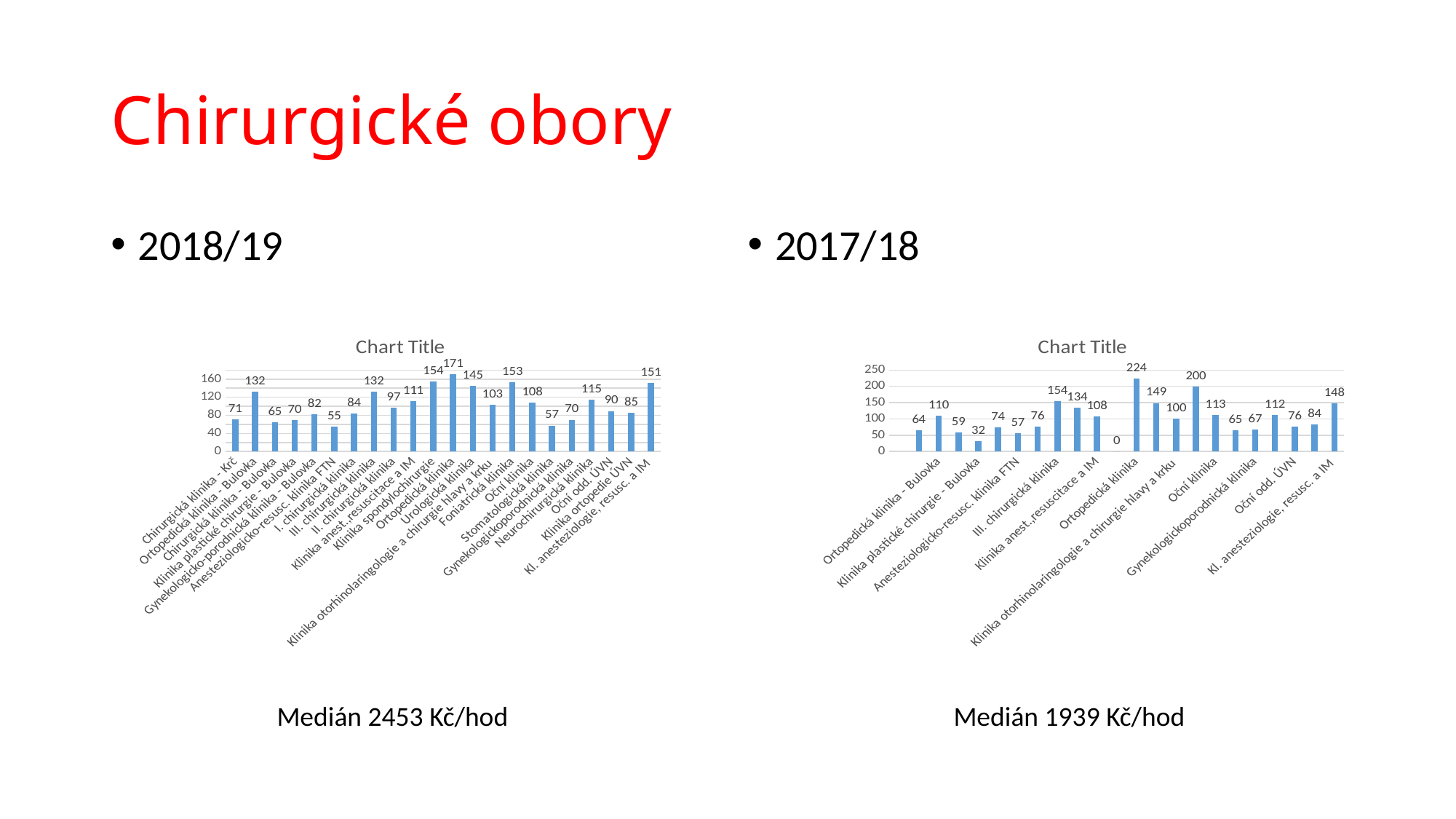
In the left chart (2018/19), which category has the lowest value? Anesteziologicko-resusc. klinika FTN What type of chart is shown on the left (2018/19) side of the slide? bar chart In the right chart (2017/18), what is the highest value shown? 224 In the left chart (2018/19), which is larger: the value for Urologická klinika or the value for Oční klinika? Urologická klinika In the left chart (2018/19), which category has the highest value? Ortopedická klinika In the right chart (2017/18), is the value for Ortopedická klinika greater or less than 200? greater How many bars are plotted in the left chart (2018/19)? 22 What title is displayed above the right chart (2017/18)? Chart Title In the left chart (2018/19), what is the difference between the highest value (171) and the lowest value (55)? 116 In the right chart (2017/18), what is the value for Kl. anesteziologie, resusc. a IM? 148 In the left chart (2018/19), what is the value for Kl. anesteziologie, resusc. a IM? 151 In the left chart (2018/19), what is the value for Chirurgická klinika - Krč? 71